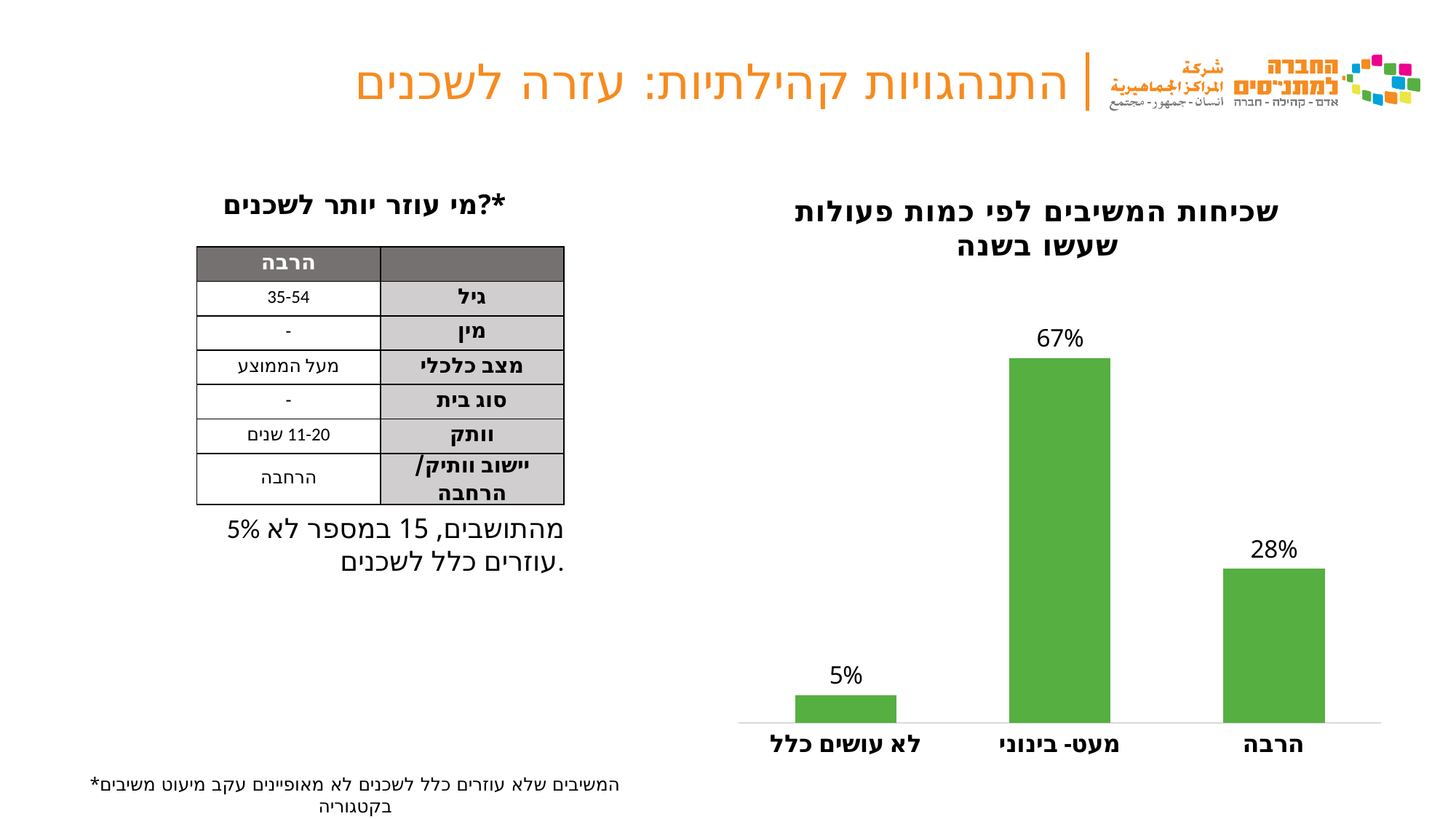
What value is shown for the category "מעט- בינוני"? 67% Which category has the lowest value? לא עושים כלל What is the title of the chart? שכיחות המשיבים לפי כמות פעולות שעשו בשנה What kind of chart is shown on the slide? Bar chart What colour are the bars in the chart? Green How many categories are shown in the bar chart? 3 What is the difference between the values for "הרבה" and "לא עושים כלל"? 23% What is the difference between the values for "מעט- בינוני" and "הרבה"? 39% What value is shown for the category "הרבה"? 28% Which is larger, the value for "הרבה" or the value for "לא עושים כלל"? הרבה Which category has the highest value? מעט- בינוני What value is shown for the category "לא עושים כלל"? 5%